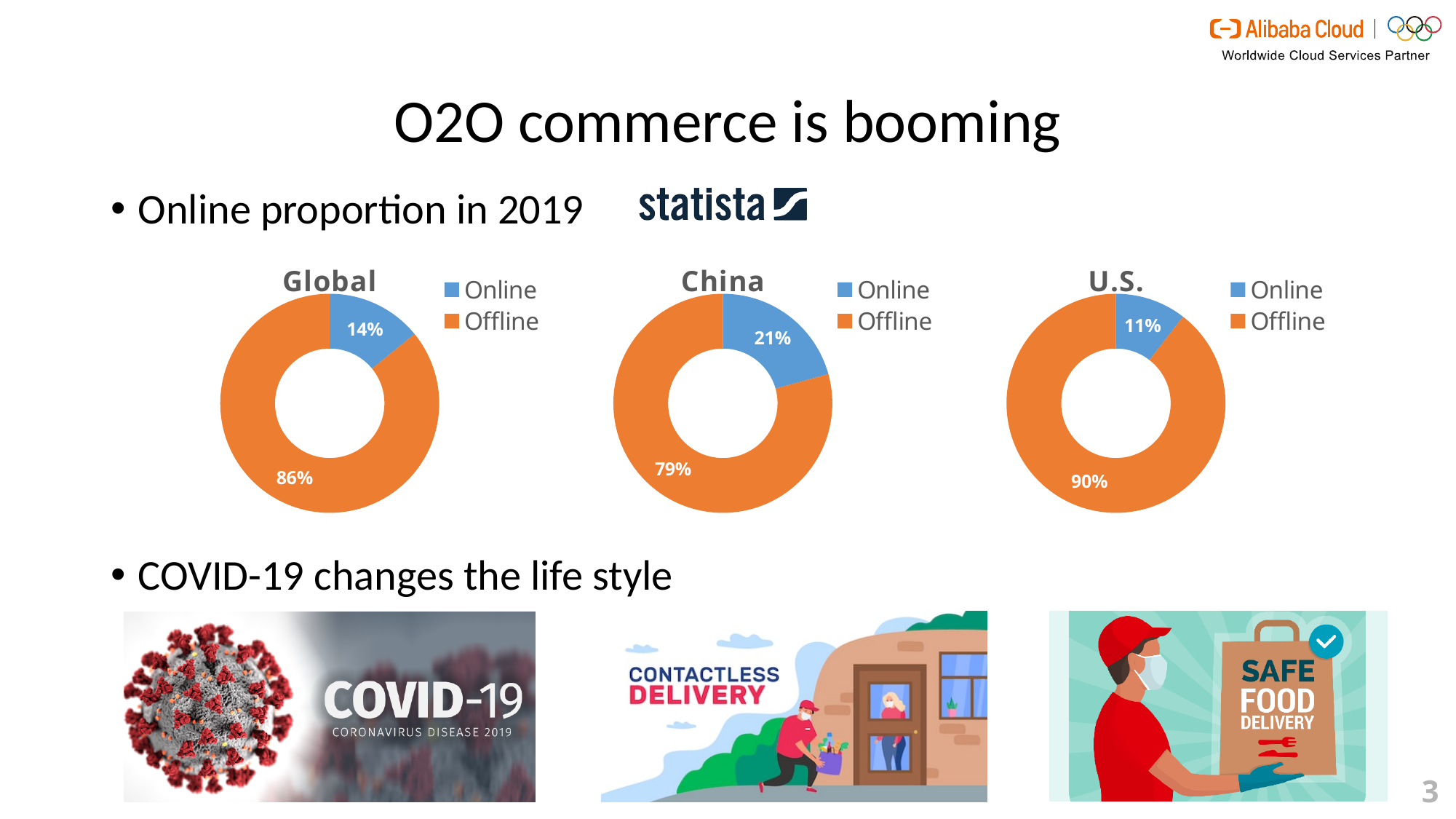
Which of the three charts shows the highest Online share? China Which of the three charts shows the lowest Online share? U.S. How many series does the legend of the Global chart list? 2 What is the difference between the Online share in the China chart and the Online share in the U.S. chart? 10% In the Global chart, what is the Offline share? 86% In the China chart, what is the Offline share? 79% In the U.S. chart, what is the Online share? 11% What kind of chart is the China chart? Doughnut (pie) chart In the U.S. chart, which colour represents Offline? Orange In the U.S. chart, what is the Offline share? 90% In the Global chart, what is the Online share? 14% Is the Online share larger in the Global chart or in the China chart? China